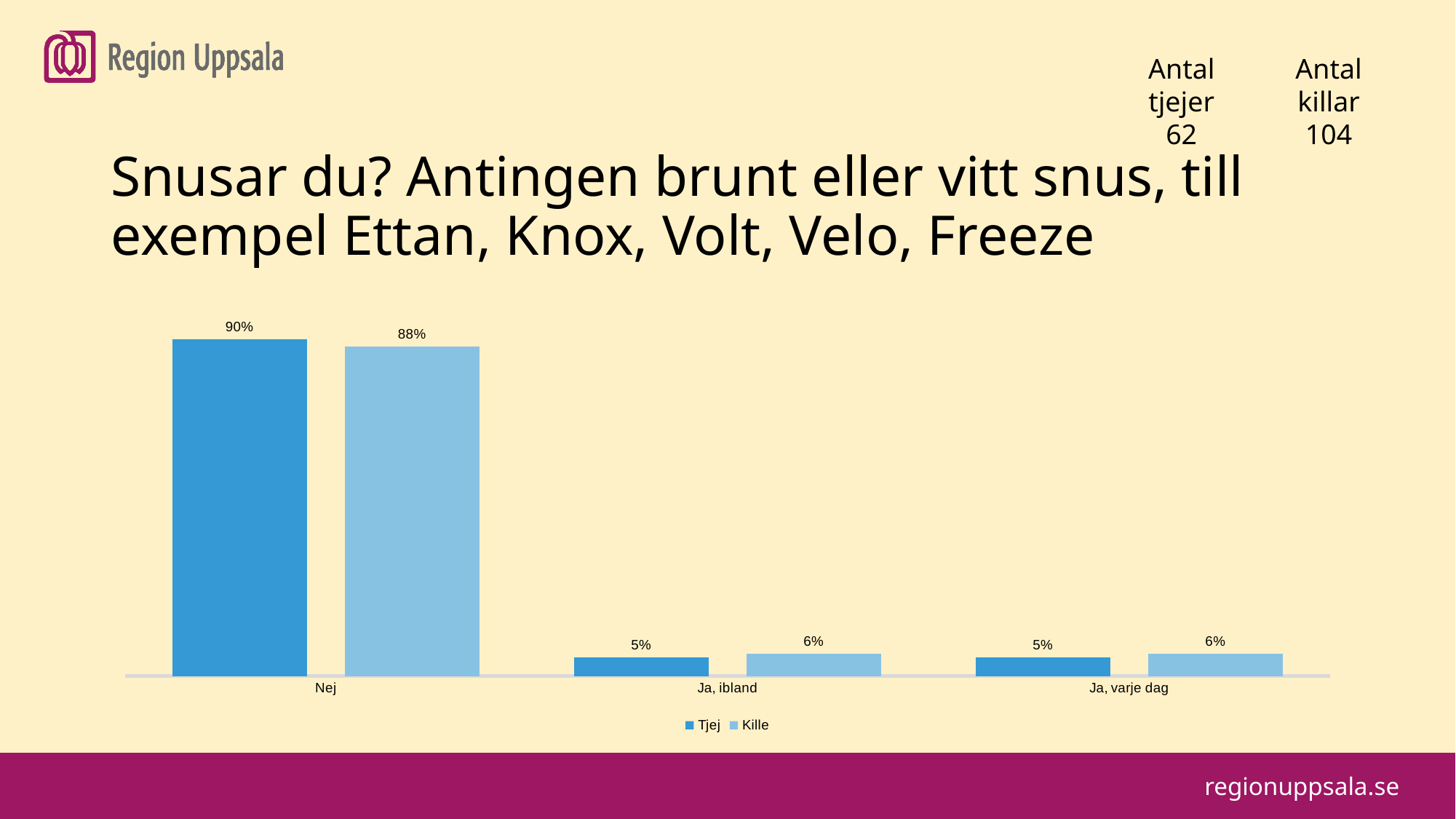
How many series does the legend list? 2 What is the value for Kille in the Ja, varje dag category? 6% What is the difference between the Tjej and Kille values in the Nej category? 2% What is the value for Tjej in the Nej category? 90% Which category has the highest value for Tjej? Nej What is the value for Kille in the Nej category? 88% How many categories are shown on the x axis? 3 What kind of chart is shown on the slide? Bar chart Which is larger in the Ja, ibland category, the Tjej value or the Kille value? Kille What is the value for Tjej in the Ja, ibland category? 5% What is the difference between the Kille value for Nej and the Kille value for Ja, ibland? 82% What are the two series named in the legend? Tjej and Kille